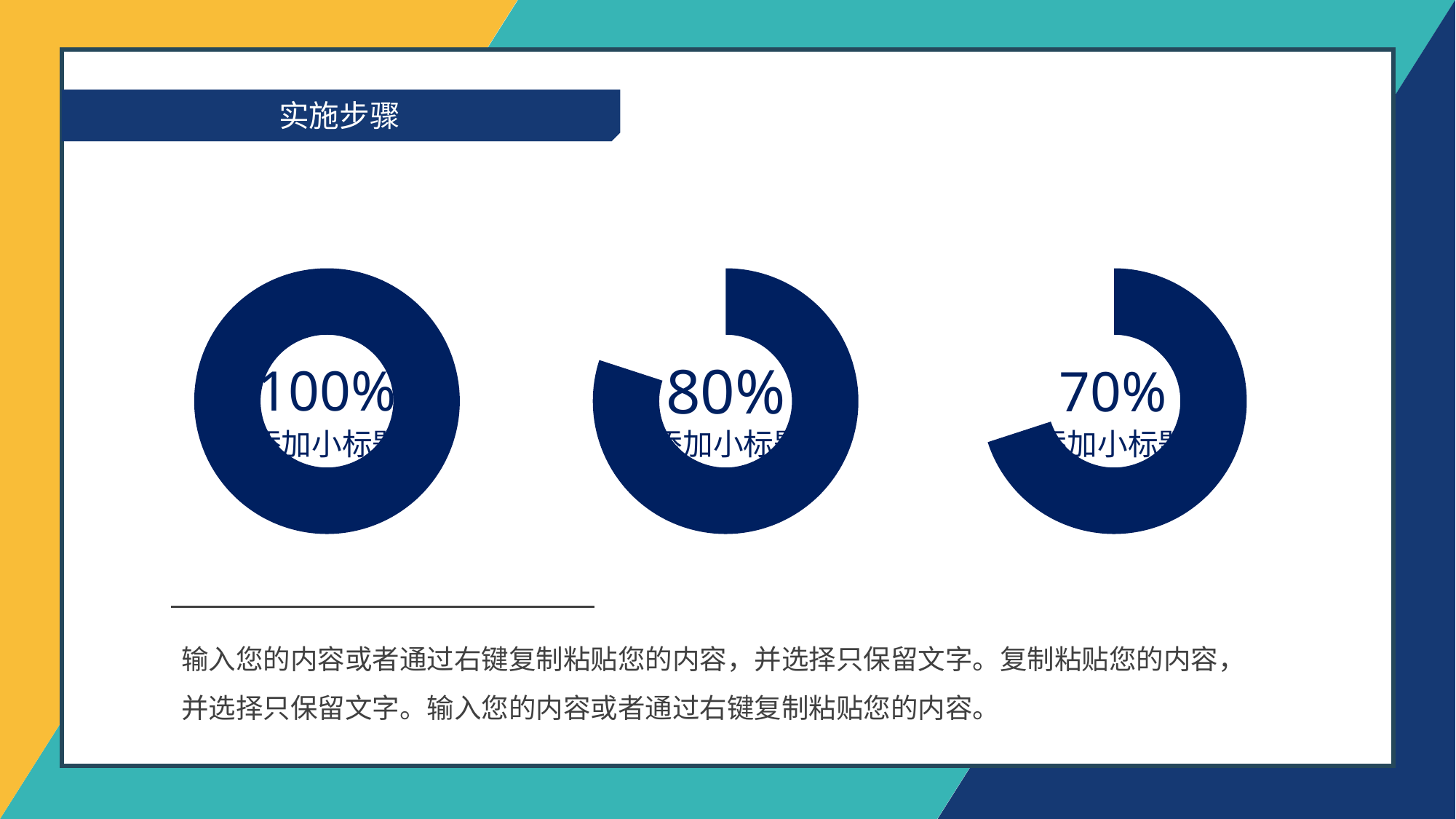
What is the difference between the percentages in the middle and right donut charts? 10% What is the difference between the percentages in the left and right donut charts? 30% What percentage is shown in the left donut chart? 100% What percentage is shown in the right donut chart? 70% Which of the three donut charts shows the highest percentage? The left one (100%) Is the value in the right donut chart greater or less than 80%? less What percentage is shown in the middle donut chart? 80% How many donut charts are on the slide? 3 Which shows a larger value, the middle donut chart or the right donut chart? The middle donut chart Which of the three donut charts shows the lowest percentage? The right one (70%) What kind of chart is used to display the percentages on this slide? Donut chart What is the title shown in the header bar of the slide? 实施步骤